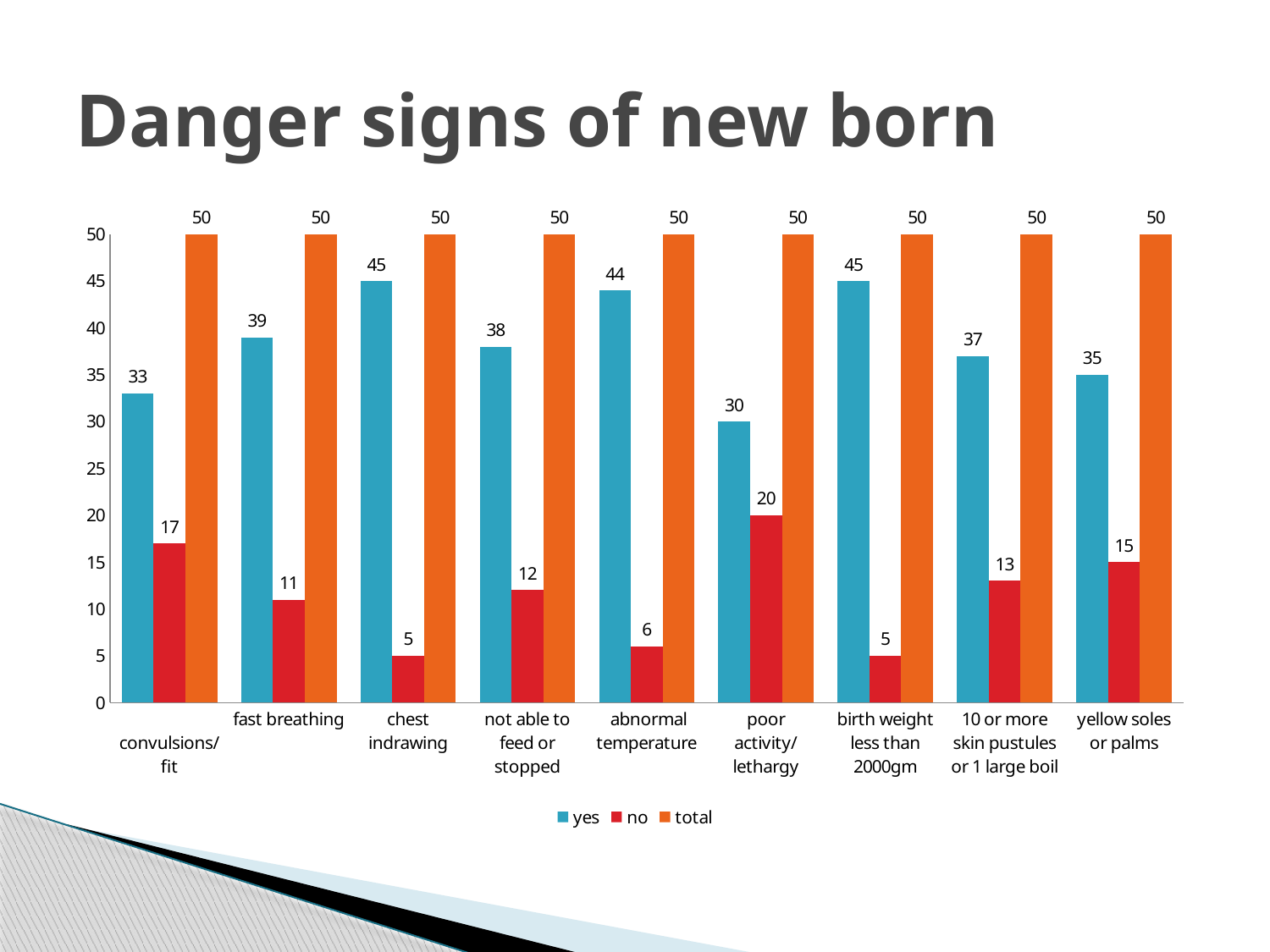
How many categories are shown on the x axis? 9 What kind of chart is shown on the slide? bar chart What is the 'total' value for each category? 50 Which is larger, the 'yes' value for not able to feed or stopped or the 'yes' value for 10 or more skin pustules or 1 large boil? not able to feed or stopped Which category has the lowest 'yes' value? poor activity/lethargy Which category has the highest 'no' value? poor activity/lethargy What is the 'yes' value for fast breathing? 39 How many series does the legend list? 3 What is the difference between the 'yes' and 'no' values for convulsions/fit? 16 What is the 'no' value for poor activity/lethargy? 20 What is the 'yes' value for yellow soles or palms? 35 What is the title of the slide? Danger signs of new born